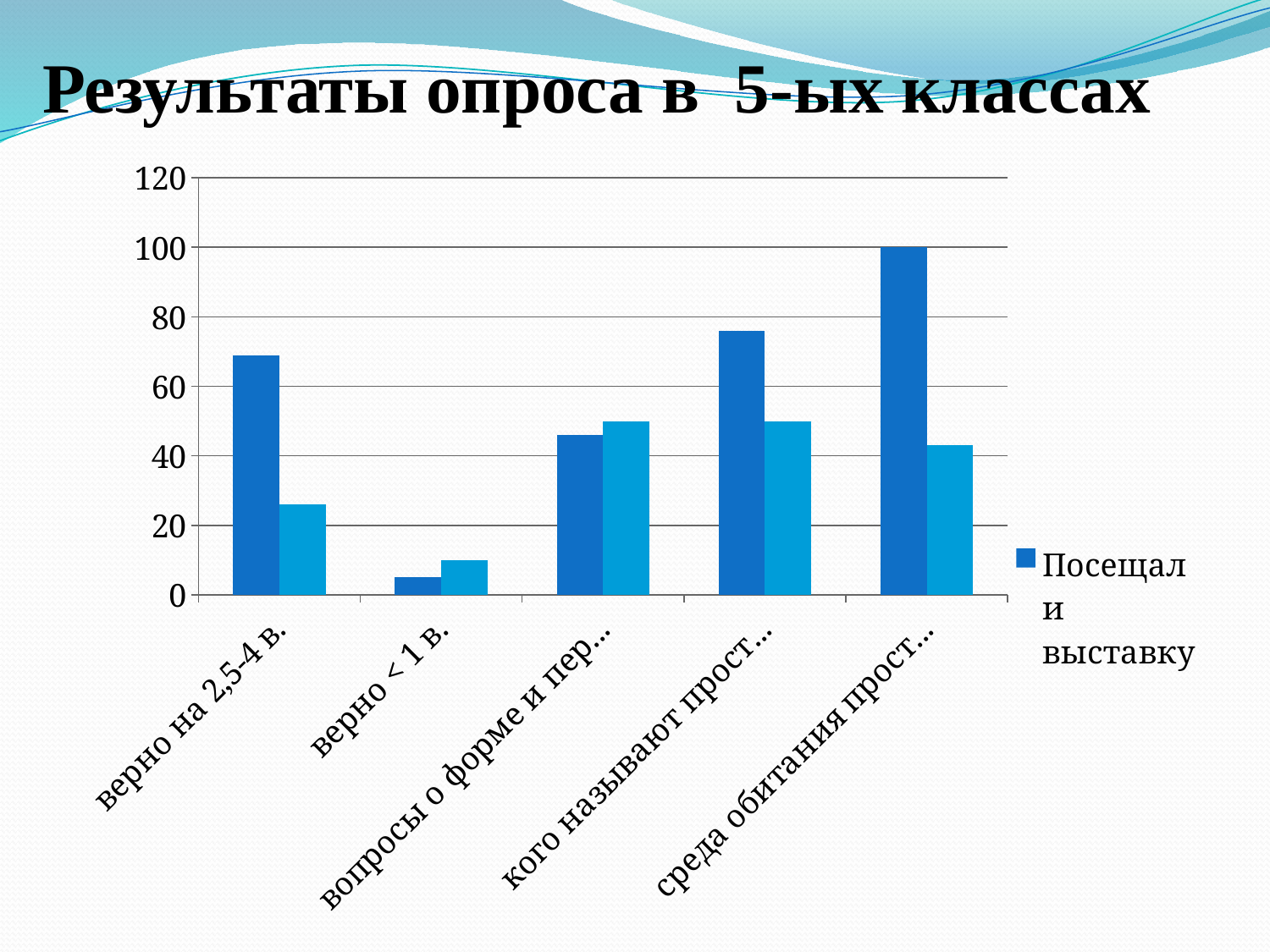
Is the "Посещали выставку" value for "кого называют прост..." greater or less than 80? less Is the "Посещали выставку" value for "вопросы о форме и пер..." greater or less than 40? greater How many categories are shown on the x axis of the chart? 5 What is the value of the "Посещали выставку" bar for "среда обитания прост..."? 100 What is the title of the slide containing the chart? Результаты опроса в 5-ых классах Which has the larger "Посещали выставку" value: "верно на 2,5-4 в." or "кого называют прост..."? кого называют прост... Is the "Посещали выставку" value for "верно на 2,5-4 в." greater or less than 60? greater What series name is shown in the chart's legend? Посещали выставку Which category has the lowest "Посещали выставку" bar? верно < 1 в. What kind of chart is shown on the slide? bar chart Which category has the highest "Посещали выставку" bar? среда обитания прост...